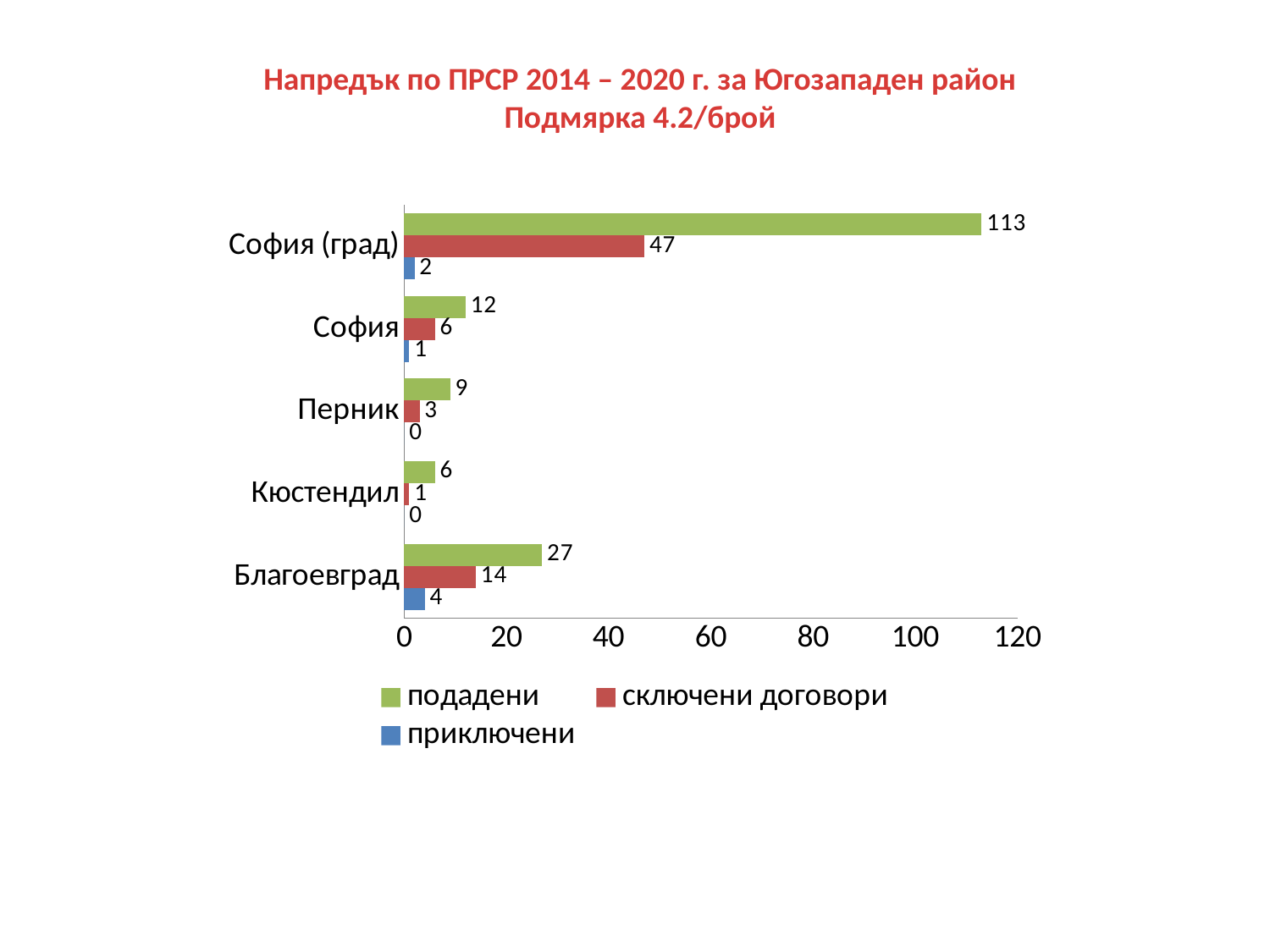
Which is larger: сключени договори for Перник or сключени договори for Благоевград? Благоевград How many categories are shown on the chart? 5 What is the value of сключени договори for Благоевград? 14 Which category has the lowest value for подадени? Кюстендил What colour represents the приключени series? blue What is the value of приключени for София? 1 What kind of chart is shown on the slide? bar chart What is the difference between подадени and сключени договори for София (град)? 66 Is the value of подадени for София (град) greater or less than 100? greater How many series does the legend list? 3 What is the value of подадени for София (град)? 113 Which category has the highest value for подадени? София (град)